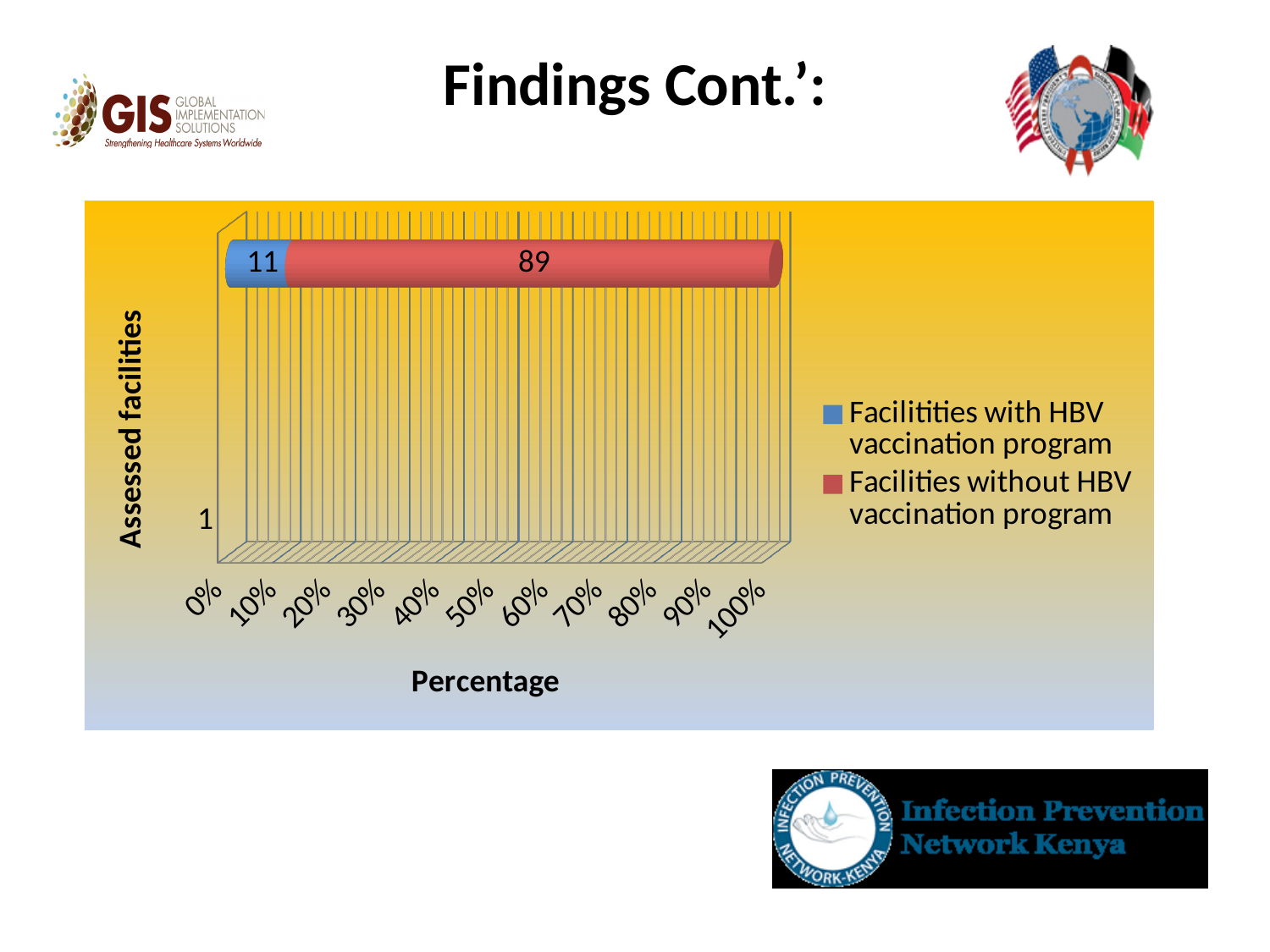
What is the difference between the value for Facilities without HBV vaccination program and the value for Facilitities with HBV vaccination program? 78 How many categories are plotted on the chart? 1 How many series does the legend list? 2 Which series has the larger value, Facilitities with HBV vaccination program or Facilities without HBV vaccination program? Facilities without HBV vaccination program Is the value for Facilitities with HBV vaccination program greater or less than 20%? less What is the total of the stacked bar? 100 What kind of chart is shown on the slide? Stacked bar chart What is the label of the vertical axis? Assessed facilities Is the value for Facilities without HBV vaccination program greater or less than 50%? greater What is the label of the horizontal axis? Percentage What value is shown for Facilities without HBV vaccination program? 89 What value is shown for Facilitities with HBV vaccination program? 11